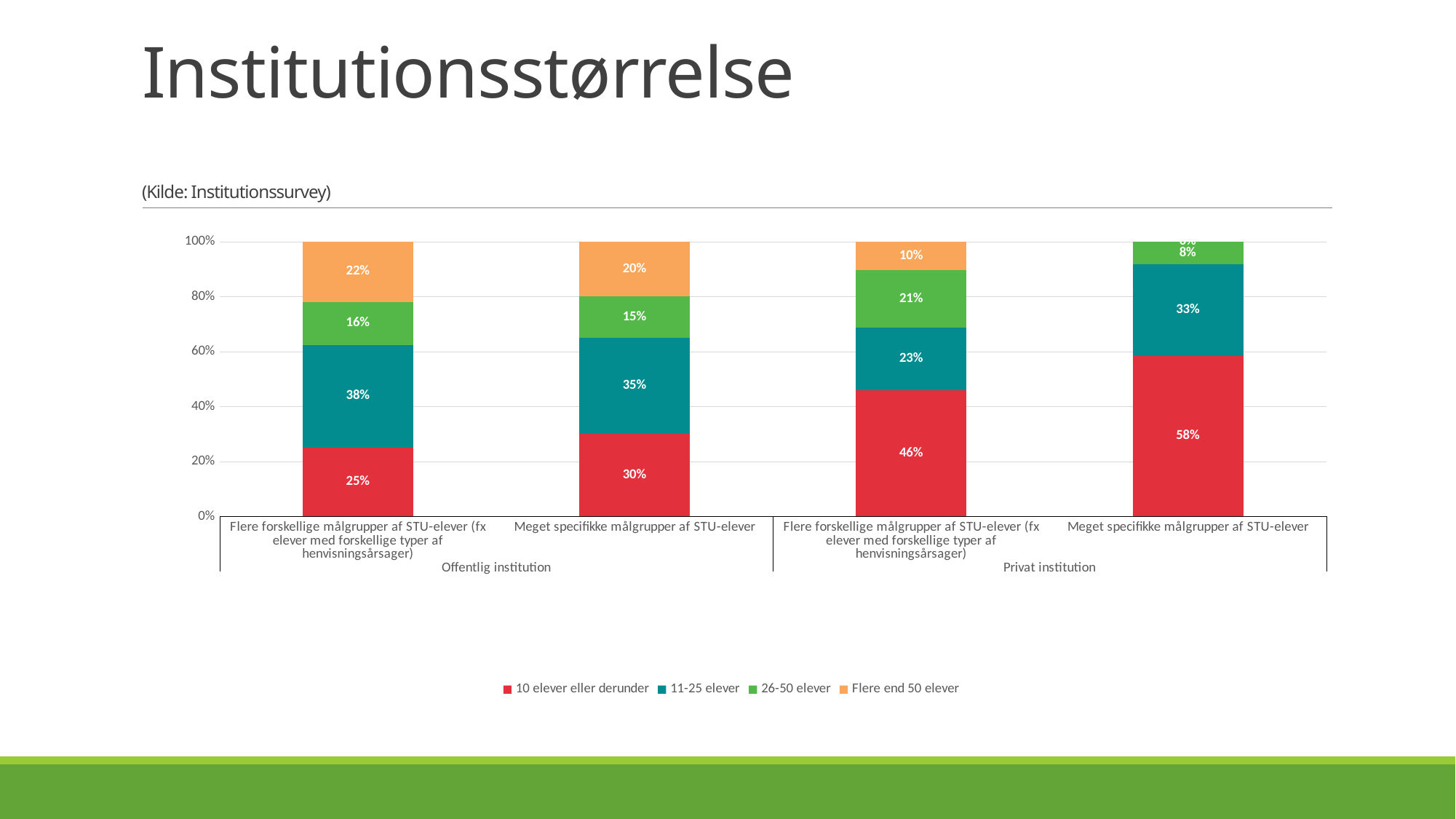
Which is larger: the "Flere end 50 elever" value for "Flere forskellige målgrupper af STU-elever" under "Offentlig institution" or under "Privat institution"? Offentlig institution Which bar has the lowest value for "11-25 elever"? Flere forskellige målgrupper af STU-elever (Privat institution) What source is cited for the chart? Institutionssurvey What is the value for "26-50 elever" in the "Meget specifikke målgrupper af STU-elever" bar under "Offentlig institution"? 15% Which bar has the highest value for "10 elever eller derunder"? Meget specifikke målgrupper af STU-elever (Privat institution) What is the difference between the "10 elever eller derunder" values for the two bars under "Offentlig institution"? 5% What is the value for "Flere end 50 elever" in the "Flere forskellige målgrupper af STU-elever" bar under "Privat institution"? 10% How many stacked bars are shown in the chart? 4 What is the value for "11-25 elever" in the "Flere forskellige målgrupper af STU-elever" bar under "Offentlig institution"? 38% How many series does the legend list? 4 What is the value for "10 elever eller derunder" in the "Meget specifikke målgrupper af STU-elever" bar under "Privat institution"? 58% What kind of chart is shown on the slide? Stacked bar chart